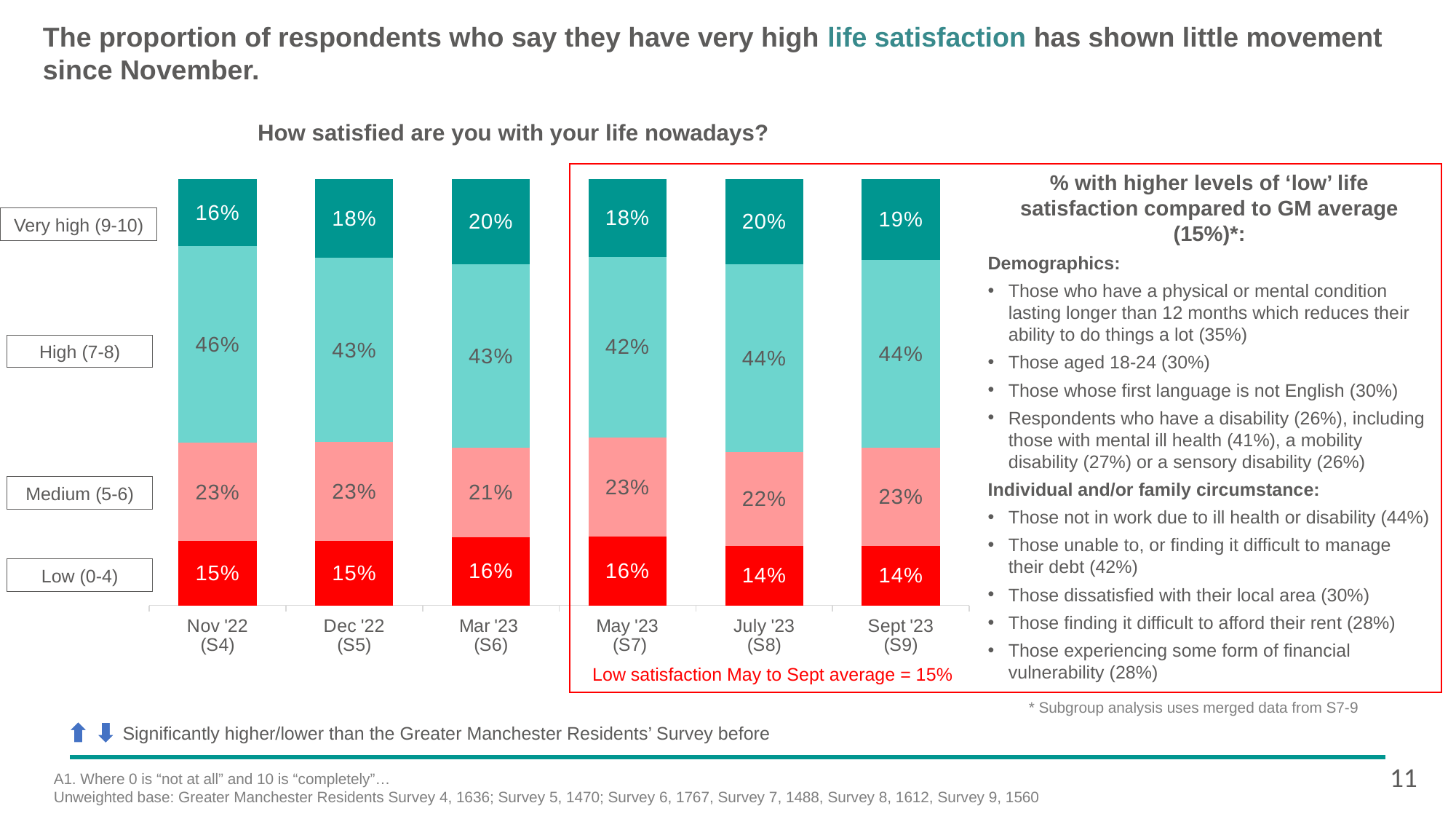
In which survey wave was the High (7-8) share the highest? Nov '22 (S4) What type of chart is used to show the life satisfaction results? Stacked bar chart What is the value for Medium (5-6) life satisfaction in Mar '23 (S6)? 21% What is the value for High (7-8) life satisfaction in May '23 (S7)? 42% What percentage of respondents reported low (0-4) life satisfaction in Sept '23 (S9)? 14% Which is larger: the Low (0-4) share in Mar '23 (S6) or in July '23 (S8)? Mar '23 (S6) What is the difference between the Very high (9-10) share in Mar '23 (S6) and in Nov '22 (S4)? 4 percentage points What percentage of respondents reported very high (9-10) life satisfaction in Nov '22 (S4)? 16% How many survey waves are shown on the x axis of the chart? 6 How many satisfaction categories (series) are shown in the stacked bars? 4 In which survey wave was the Very high (9-10) share the lowest? Nov '22 (S4) What is the total of the stacked bar for Nov '22 (S4)? 100%